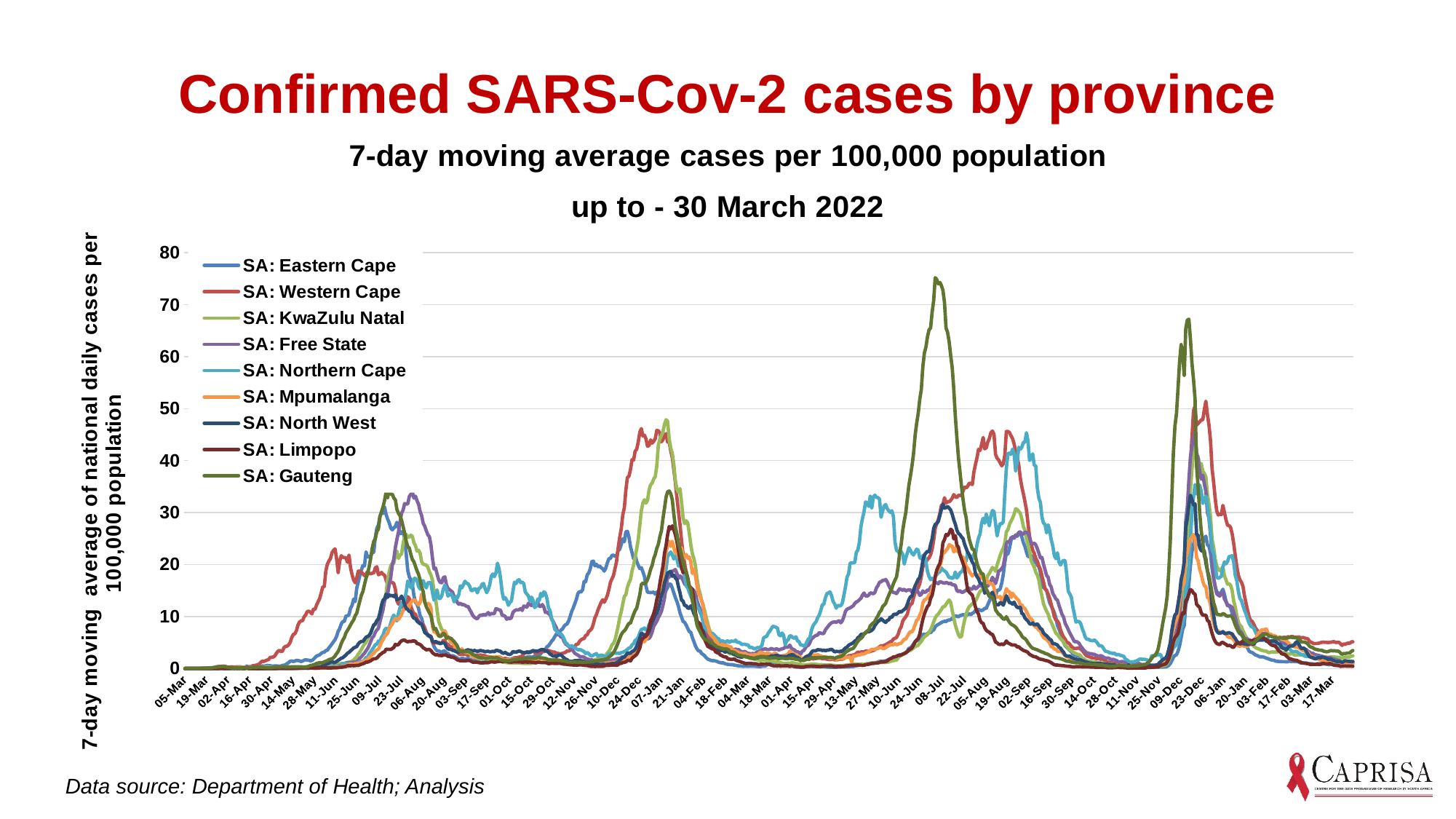
Is the value for SA: Eastern Cape at its peak around 10-Dec greater or less than 20? greater Which province is shown by the dark green line? SA: Gauteng What type of chart is shown on the slide? line chart What is the title of the chart? Confirmed SARS-Cov-2 cases by province Which province's line reaches the highest peak on the chart? SA: Gauteng Is the peak value of SA: Northern Cape around 02-Sep greater or less than 40? greater Is the highest value reached by SA: Limpopo greater or less than 40? less In the wave around 23-Dec, which line peaks higher, SA: Gauteng or SA: Western Cape? SA: Gauteng Does the SA: Gauteng line rise or fall between 08-Jul and 05-Aug? fall How many series does the legend list? 9